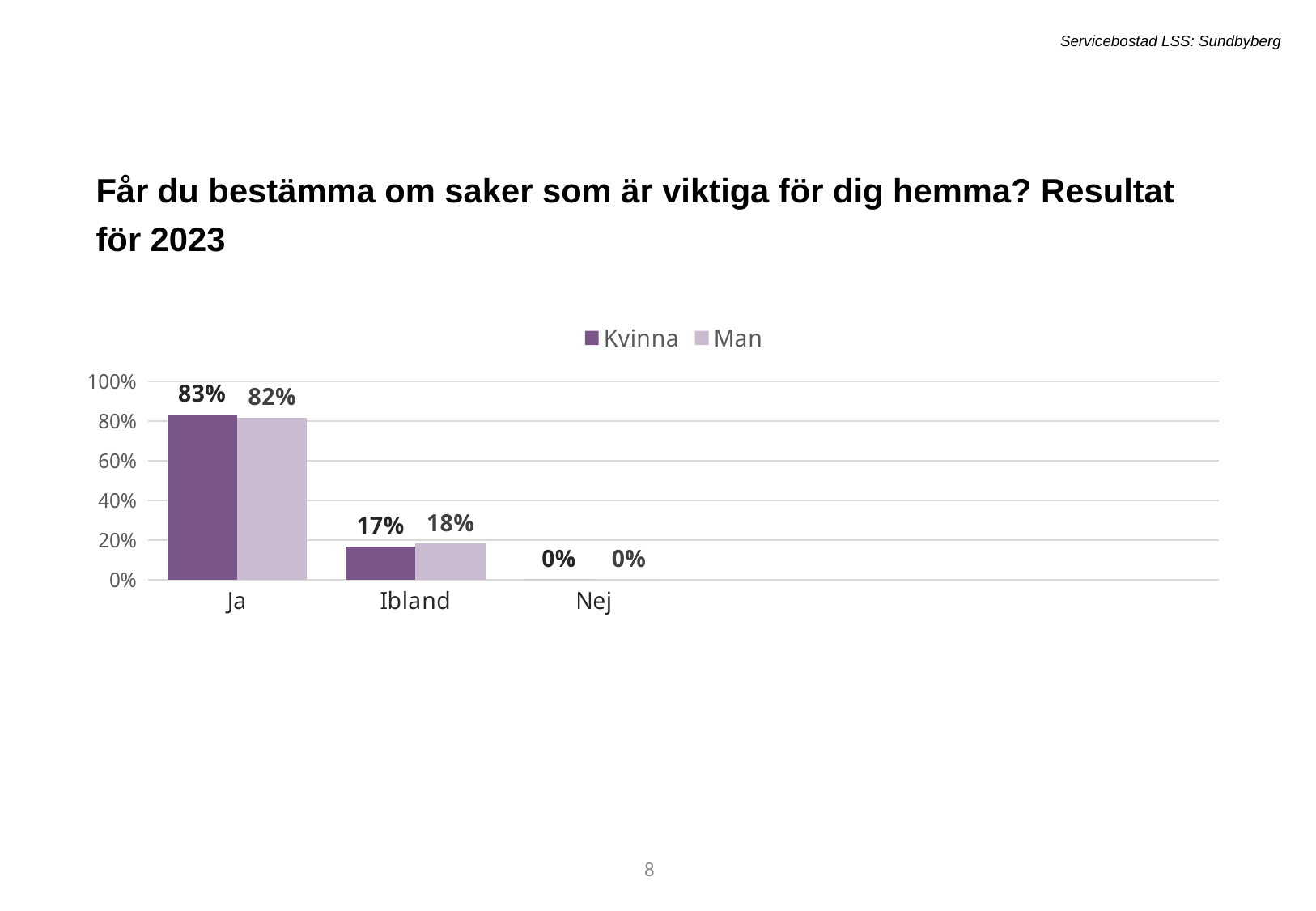
Which series is shown in the darker purple colour? Kvinna What is the difference between the Kvinna and Man values in the Ja category? 1% What is the difference between the Kvinna values for Ja and Ibland? 66% How many series does the legend list? 2 How many categories are shown on the x axis? 3 What is the value for Kvinna in the Nej category? 0% What is the value for Man in the Ibland category? 18% What kind of chart is shown on the slide? Bar chart What is the value for Kvinna in the Ja category? 83% Which category has the lowest value for Kvinna? Nej Which is larger in the Ibland category, Kvinna or Man? Man Which category has the highest value for Man? Ja